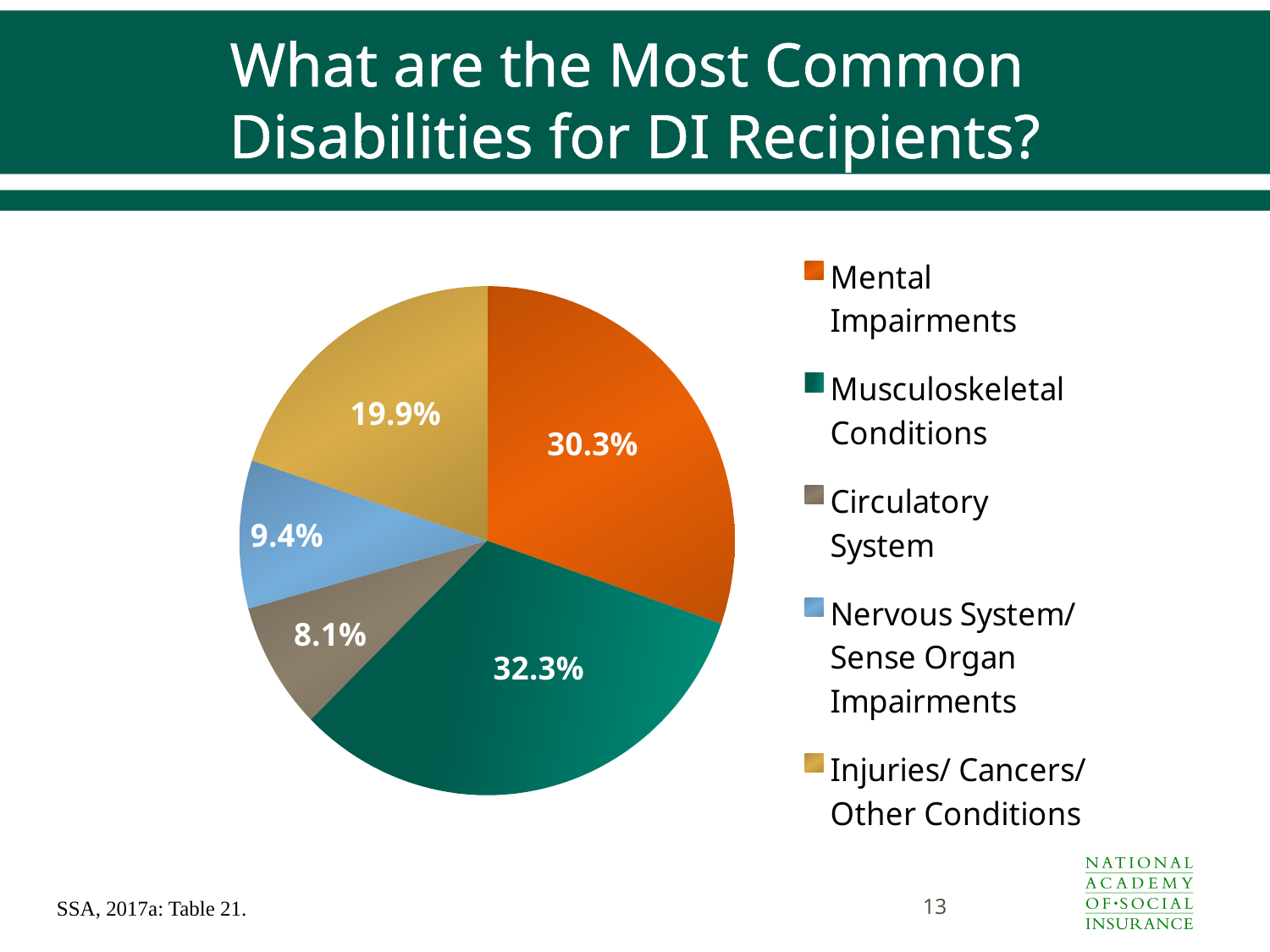
What share of DI recipients have Injuries/ Cancers/ Other Conditions? 19.9% Which category has the smallest share of the pie? Circulatory System What colour is the slice for Injuries/ Cancers/ Other Conditions? gold Which is larger: the share for Nervous System/ Sense Organ Impairments or the share for Circulatory System? Nervous System/ Sense Organ Impairments What share of DI recipients have Musculoskeletal Conditions? 32.3% How many categories does the pie chart show? 5 What share of DI recipients have Nervous System/ Sense Organ Impairments? 9.4% What is the difference in percentage points between Musculoskeletal Conditions and Mental Impairments? 2.0 What share of DI recipients have Mental Impairments? 30.3% What share of DI recipients have Circulatory System disabilities? 8.1% What kind of chart is shown on the slide? pie chart Which category has the largest share of the pie? Musculoskeletal Conditions